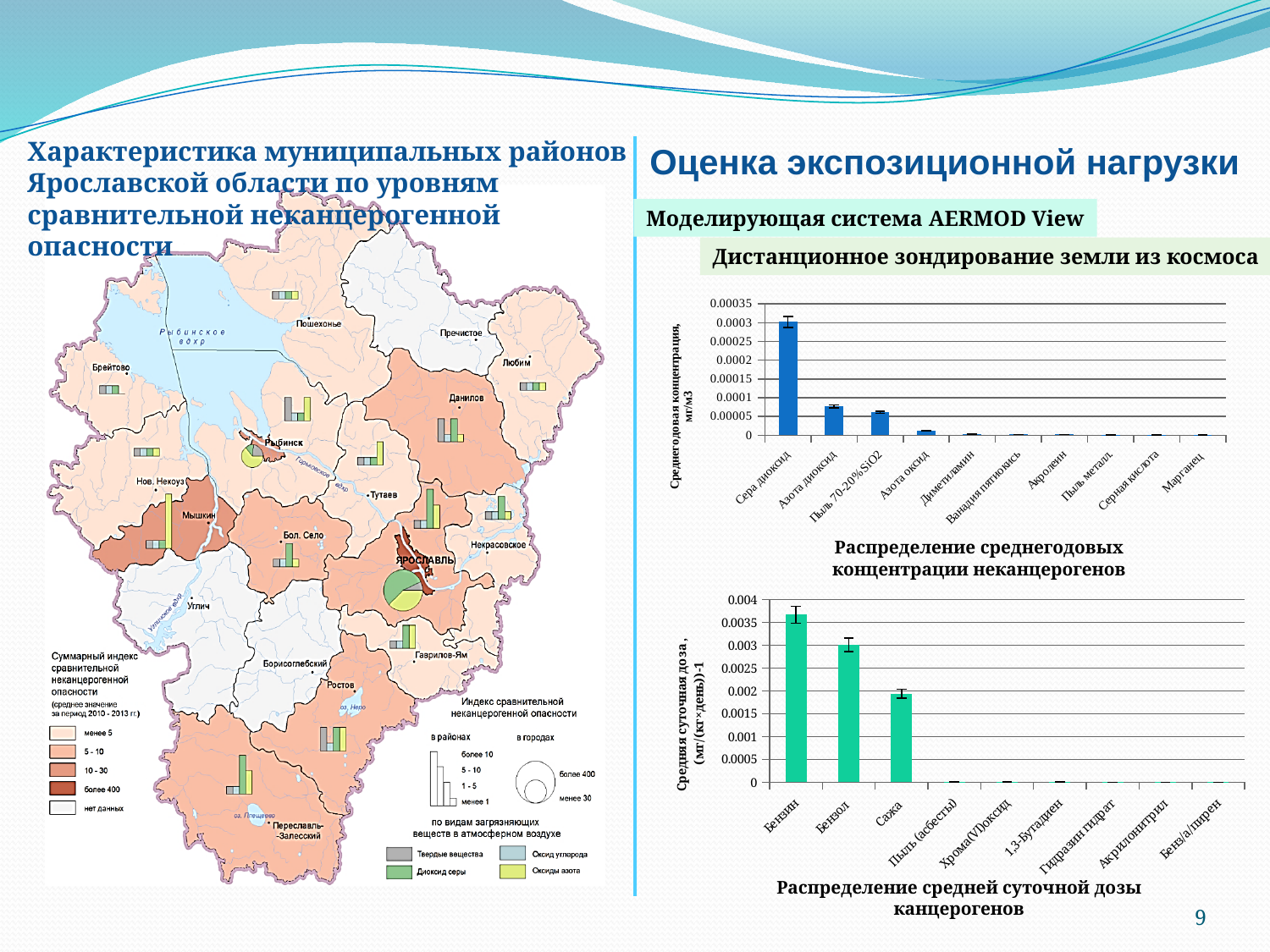
In the chart 'Распределение среднегодовых концентрации неканцерогенов', how many substances are shown on the x axis? 10 In the chart 'Распределение средней суточной дозы канцерогенов', is the value for Бензол greater or less than 0.0035? less What kind of chart is the chart titled 'Распределение среднегодовых концентрации неканцерогенов'? bar chart In the chart 'Распределение средней суточной дозы канцерогенов', which is larger, the value for Бензол or the value for Сажа? Бензол In the chart 'Распределение среднегодовых концентрации неканцерогенов', is the value for Сера диоксид greater or less than 0.00025? greater In the chart 'Распределение средней суточной дозы канцерогенов', how many substances are shown on the x axis? 9 What kind of chart is the chart titled 'Распределение средней суточной дозы канцерогенов'? bar chart In the chart 'Распределение средней суточной дозы канцерогенов', do the values rise or fall from left to right along the x axis? fall In the chart 'Распределение среднегодовых концентрации неканцерогенов', is the value for Азота диоксид greater or less than 0.0001? less In the chart 'Распределение среднегодовых концентрации неканцерогенов', which substance has the highest average annual concentration? Сера диоксид In the chart 'Распределение средней суточной дозы канцерогенов', which substance has the highest average daily dose? Бензин What is the y-axis title of the chart 'Распределение среднегодовых концентрации неканцерогенов'? Среднегодовая концентрация, мг/м3